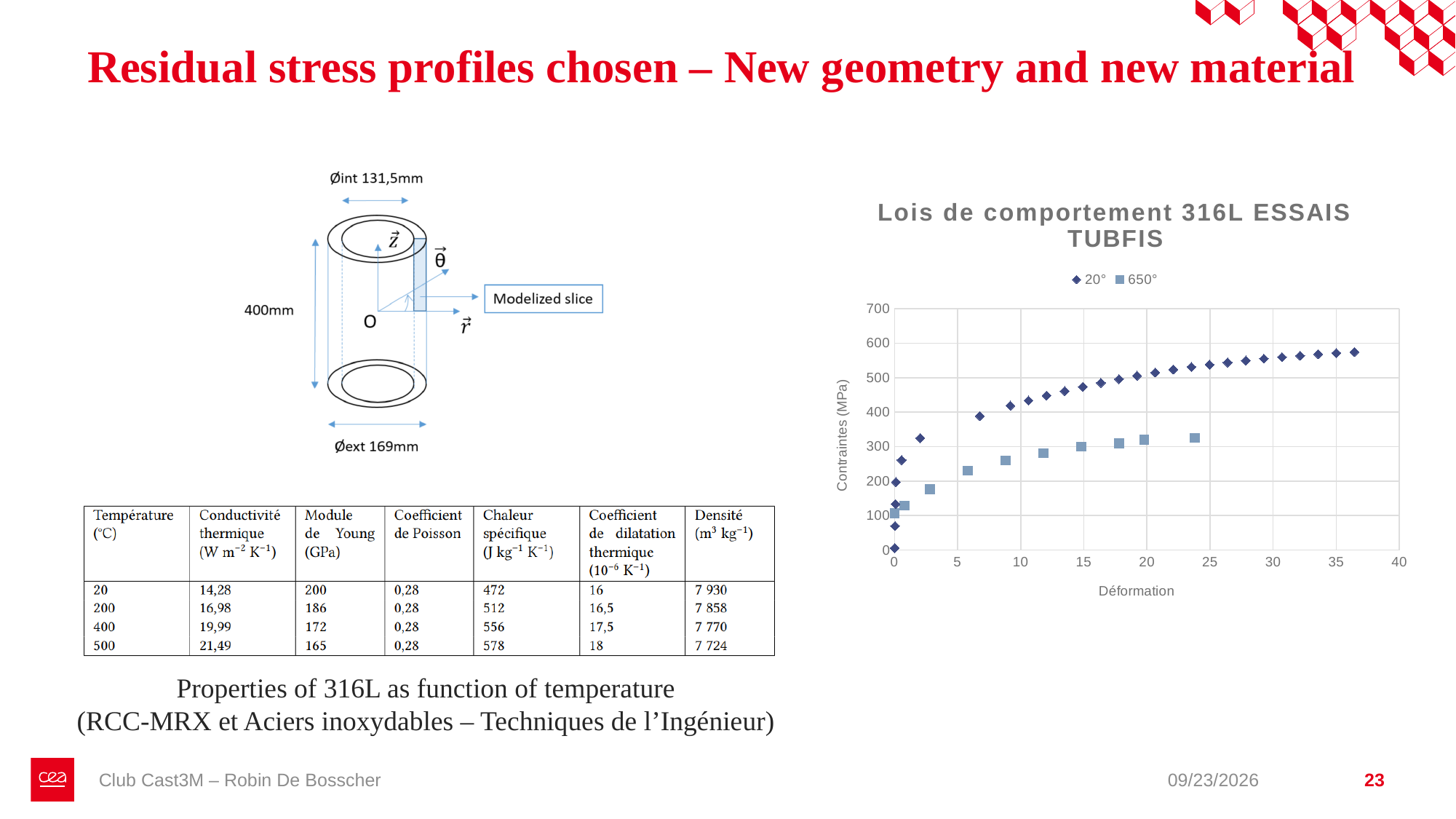
At a Déformation of about 20, which series has the higher Contraintes value, 20° or 650°? 20° Which series reaches the higher Contraintes values overall, 20° or 650°? 20° What kind of chart is shown on the slide? scatter chart Do the values of the 20° series rise or fall as Déformation increases? rise Is the highest Contraintes value of the 20° series greater or less than 500? greater What is the title of the chart? Lois de comportement 316L ESSAIS TUBFIS How many series does the legend of the chart list? 2 What are the two series named in the chart legend? 20° and 650° Do the values of the 650° series rise or fall as Déformation increases? rise Is the Contraintes value of the 650° series at a Déformation of about 15 greater or less than 200? greater Is the highest Contraintes value of the 650° series greater or less than 400? less